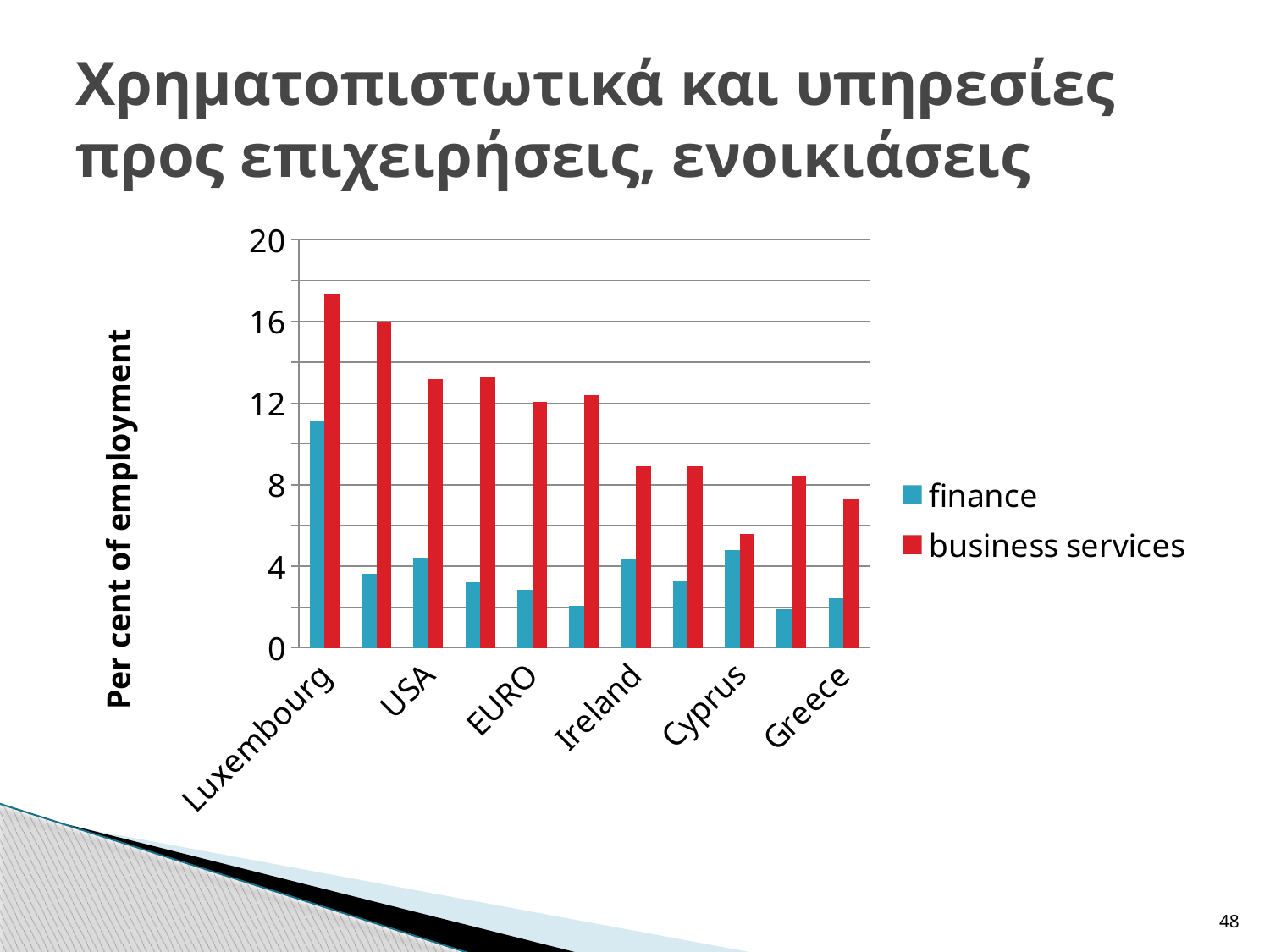
What kind of chart is shown on the slide? bar chart Which category has the highest business services value? Luxembourg Is the business services value for Greece greater or less than 8? less Is the business services value for Luxembourg greater or less than 16? greater Is the business services value for USA greater or less than 12? greater What is the title of the vertical axis? Per cent of employment How many series does the legend list? 2 Which category has the highest finance value? Luxembourg Which is larger, the finance value for Luxembourg or the finance value for USA? Luxembourg